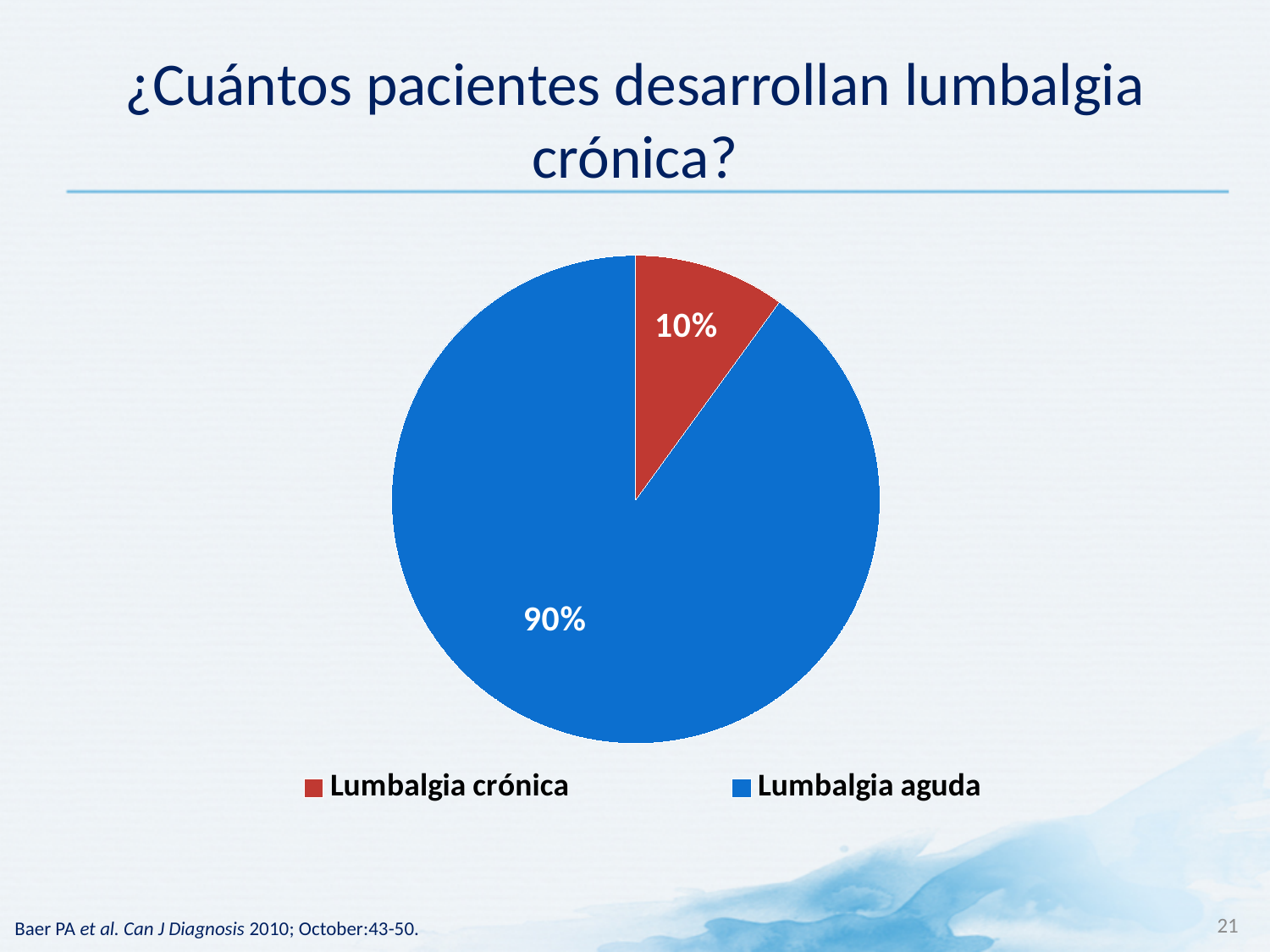
What colour is the Lumbalgia aguda slice? blue What kind of chart is shown on the slide? pie chart Which slice of the pie is the largest? Lumbalgia aguda How many slices does the pie chart have? 2 Which is larger, the Lumbalgia crónica slice or the Lumbalgia aguda slice? Lumbalgia aguda What is the difference in percentage points between the Lumbalgia aguda slice and the Lumbalgia crónica slice? 80 What percentage of the pie is labelled Lumbalgia aguda? 90% What colour is the Lumbalgia crónica slice? red How many entries does the legend list? 2 Which slice of the pie is the smallest? Lumbalgia crónica What percentage of the pie is labelled Lumbalgia crónica? 10% What share of the pie does the Lumbalgia crónica slice represent? 10%